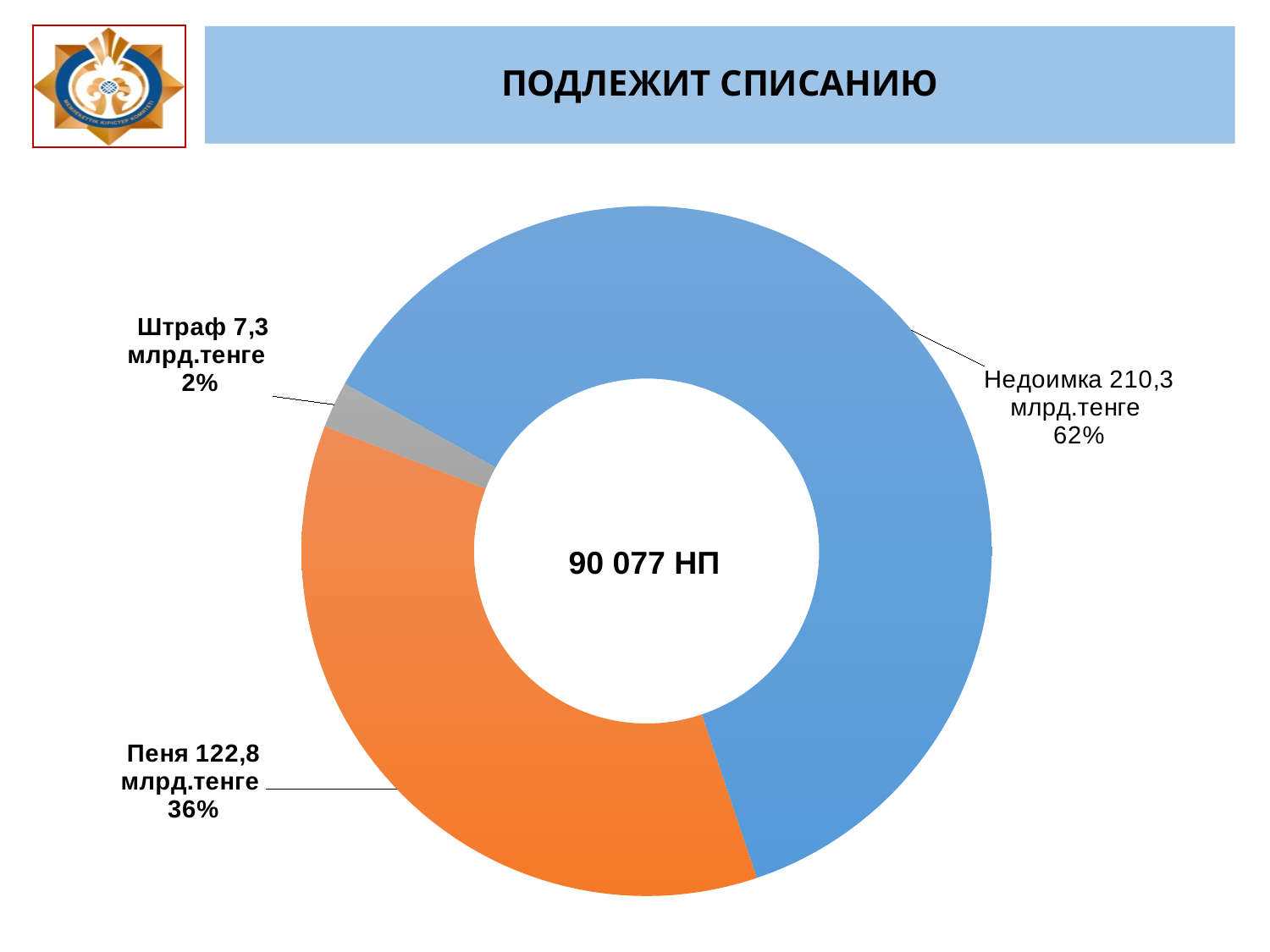
What is the value for Пеня? 122,8 млрд.тенге What share of the chart does Недоимка represent? 62% What share of the chart does Пеня represent? 36% What text is shown in the centre of the doughnut chart? 90 077 НП What is the value for Штраф? 7,3 млрд.тенге What share of the chart does Штраф represent? 2% What is the value for Недоимка? 210,3 млрд.тенге What kind of chart is shown on the slide? Doughnut (pie) chart Which category has the smallest slice? Штраф What is the difference between the values for Недоимка and Пеня? 87,5 млрд.тенге How many slices does the chart have? 3 Which category has the largest slice? Недоимка